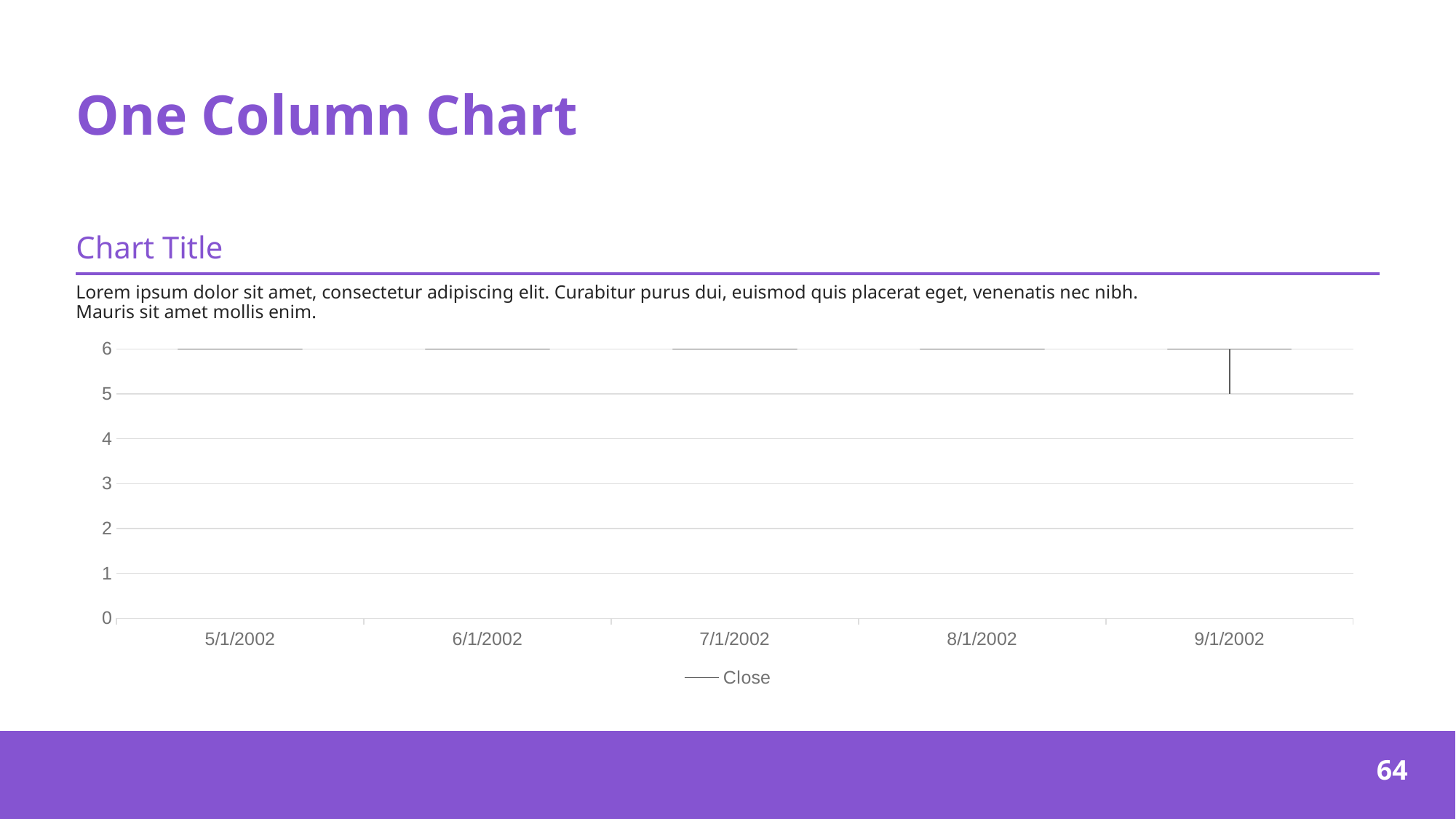
What is the name of the series shown in the chart legend? Close How many series does the chart legend list? 1 What is the title shown above the chart? Chart Title What is the first date label on the x axis? 5/1/2002 What is the highest value shown on the y axis? 6 How many dates are shown on the x axis of the chart? 5 Is the value for 8/1/2002 greater or less than 4? greater What is the last date label on the x axis? 9/1/2002 Is the value for 5/1/2002 greater or less than 3? greater Is the value for 6/1/2002 greater or less than 2? greater